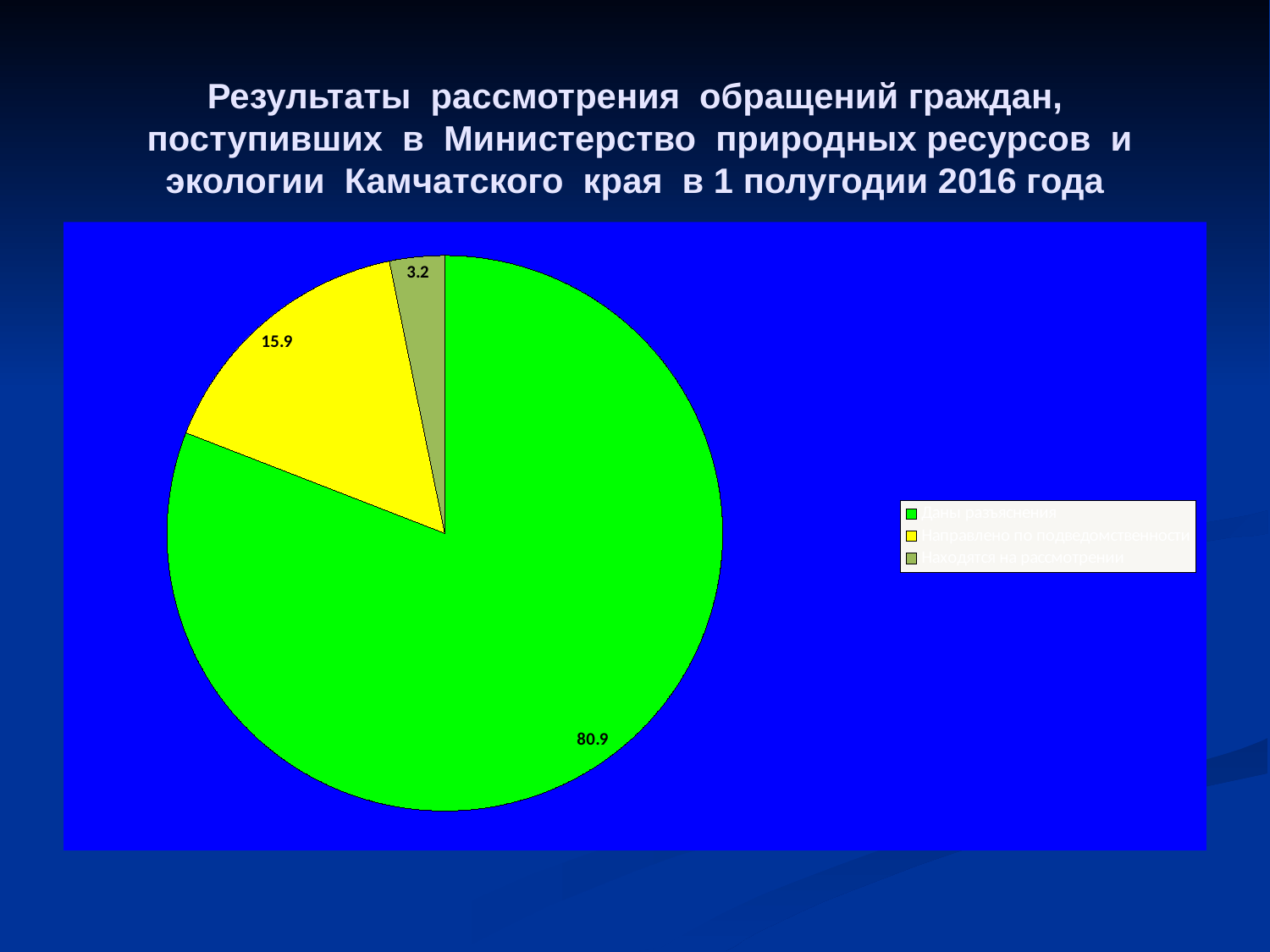
How many entries does the legend of the pie chart list? 3 What kind of chart is shown on the slide? pie chart How many slices does the pie chart have? 3 Which is larger, the yellow slice or the grey-green slice? the yellow slice What value is labelled on the small grey-green slice of the pie chart? 3.2 What value is labelled on the yellow slice of the pie chart? 15.9 What do the three labelled slice values of the pie chart add up to? 100 What value is labelled on the green slice of the pie chart? 80.9 Which slice of the pie chart is the smallest? the grey-green slice (3.2) What is the difference between the green slice value and the yellow slice value? 65 Which slice of the pie chart is the largest? the green slice (80.9) What is the difference between the yellow slice value and the grey-green slice value? 12.7